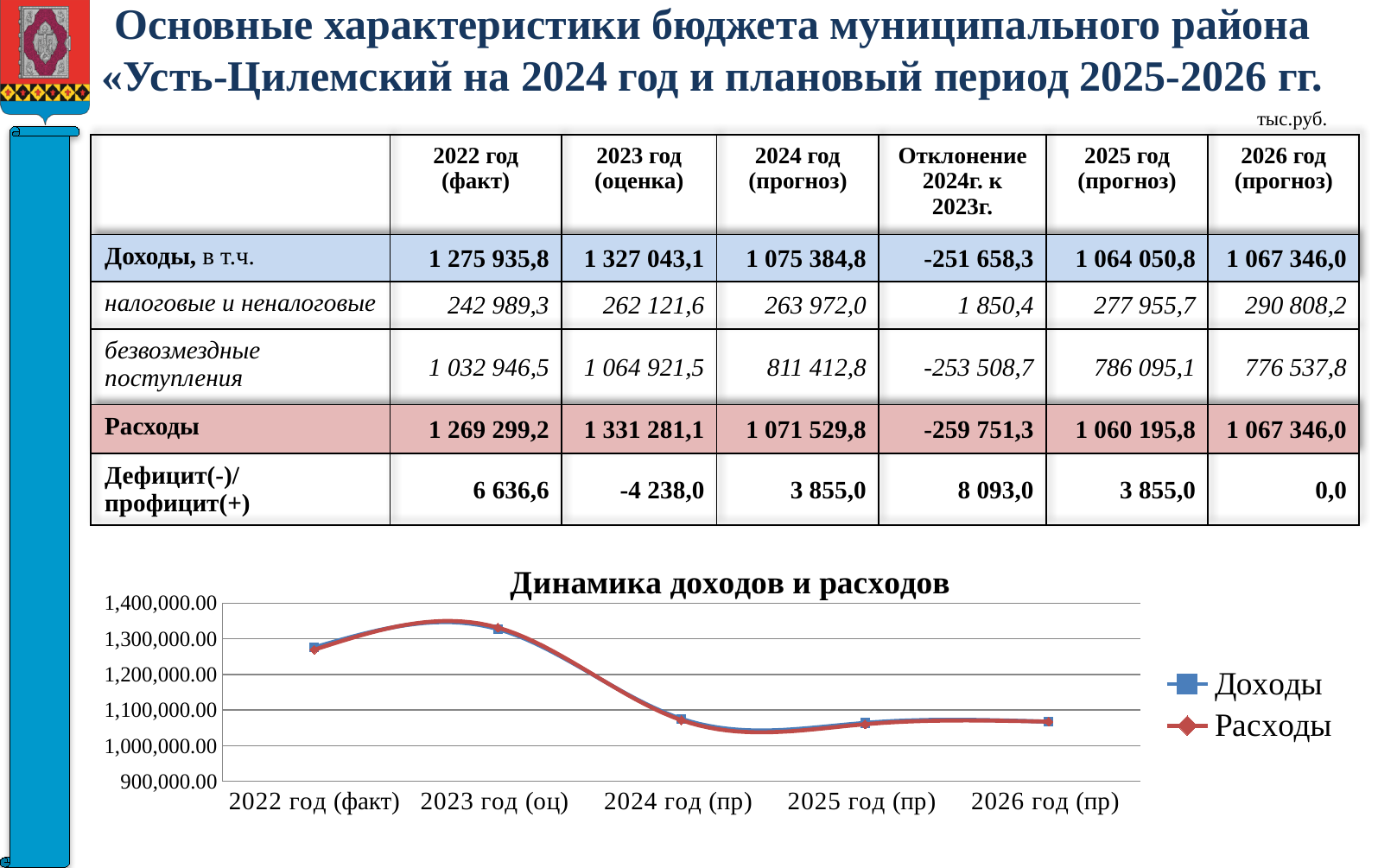
In the chart «Динамика доходов и расходов», which colour is used for the Расходы series? red In the chart «Динамика доходов и расходов», is the value for Доходы in 2022 год (факт) greater or less than 1,200,000.00? greater What kind of chart is shown under the title «Динамика доходов и расходов»? line chart In the chart «Динамика доходов и расходов», which year has the highest value for Доходы? 2023 год (оц) In the chart «Динамика доходов и расходов», which is larger: Доходы in 2023 год (оц) or Доходы in 2024 год (пр)? 2023 год (оц) How many series does the legend of the chart «Динамика доходов и расходов» list? 2 In the chart «Динамика доходов и расходов», is the value for Доходы in 2023 год (оц) greater or less than 1,300,000.00? greater What is the title of the chart on the slide? Динамика доходов и расходов How many categories are shown on the x axis of the chart «Динамика доходов и расходов»? 5 In the chart «Динамика доходов и расходов», do the values for Расходы rise or fall from 2023 год (оц) to 2024 год (пр)? fall In the chart «Динамика доходов и расходов», is the value for Расходы in 2024 год (пр) greater or less than 1,100,000.00? less In the chart «Динамика доходов и расходов», which year has the highest value for Расходы? 2023 год (оц)